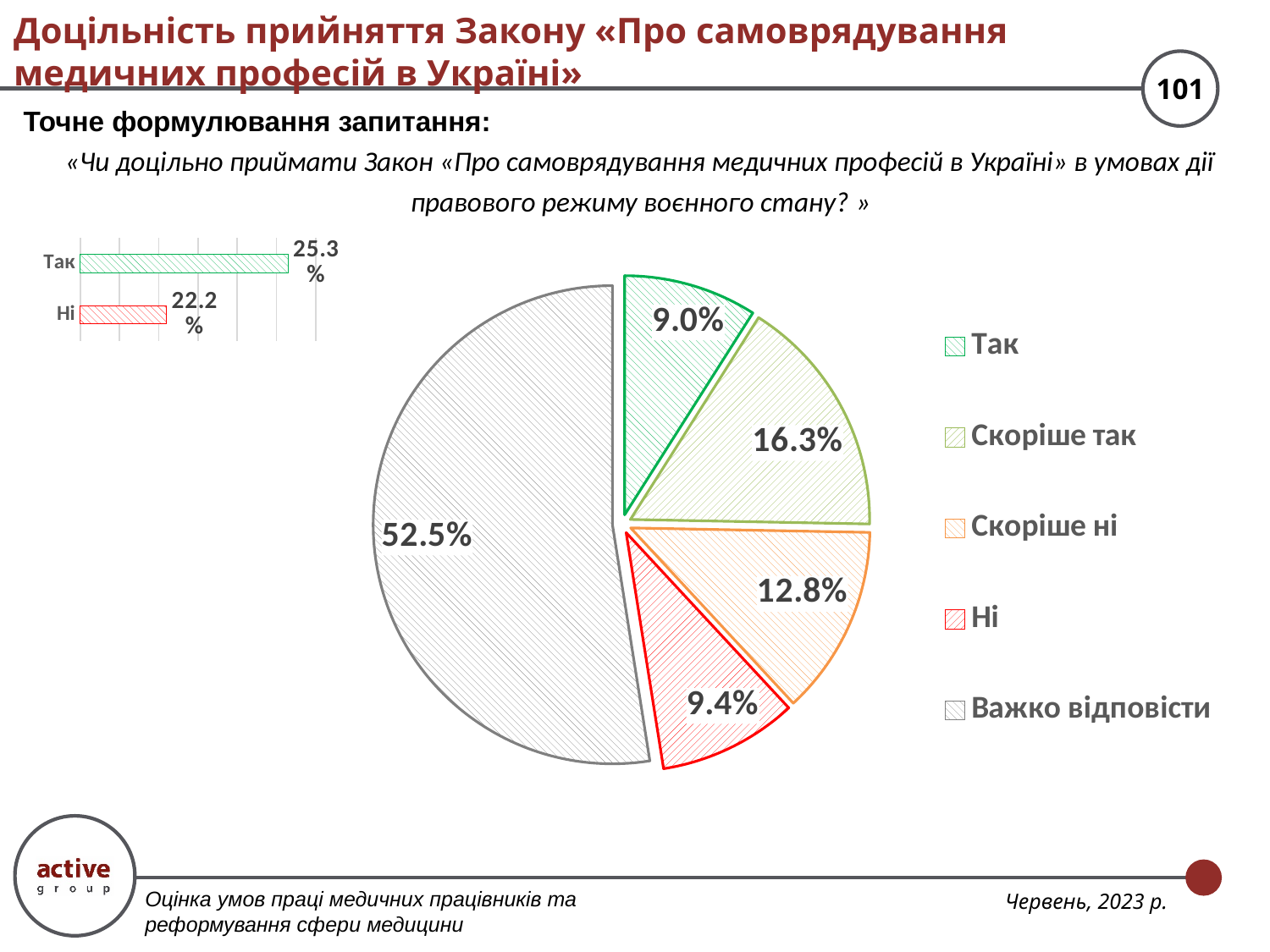
In the pie chart, which category has the largest slice? Важко відповісти In the small bar chart at the top left, what is the difference between the values for «Так» and «Ні»? 3.1% How many entries does the legend of the pie chart list? 5 In the pie chart, which is larger: the share for «Ні» or the share for «Так»? Ні In the pie chart, what share is labelled for «Скоріше так»? 16.3% In the small bar chart at the top left, what is the value for «Так»? 25.3% How many slices does the pie chart have? 5 In the pie chart, which category has the smallest slice? Так In the pie chart, what share is labelled for «Важко відповісти»? 52.5% In the pie chart, what share is labelled for «Скоріше ні»? 12.8% In the pie chart, what is the difference between the shares for «Скоріше так» and «Скоріше ні»? 3.5% What kind of chart is the small chart at the top left of the slide? Bar chart